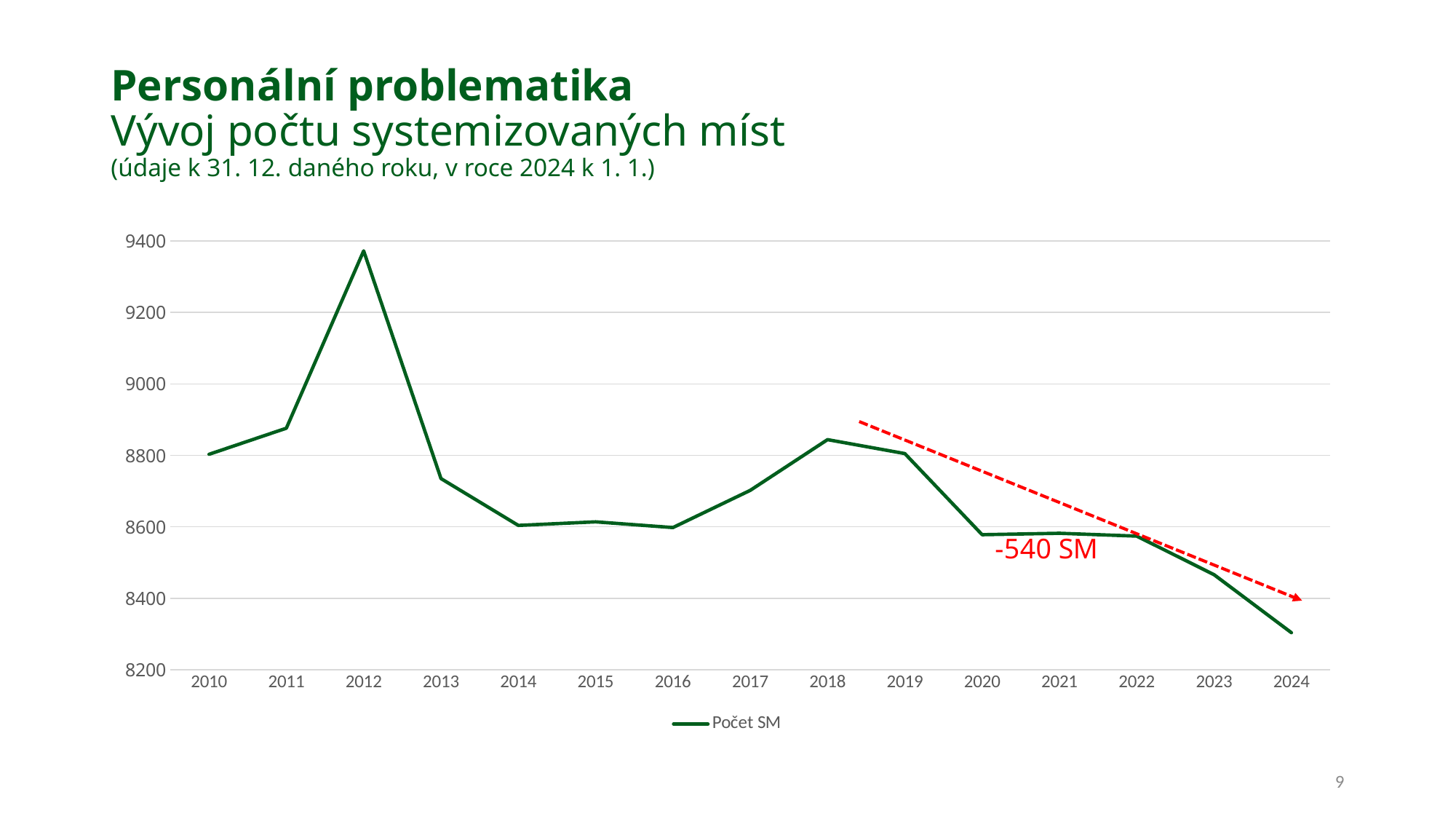
Which year has the larger value, 2011 or 2013? 2011 Which year has the highest value for Počet SM? 2012 Do the values rise or fall from 2018 to 2024? fall What kind of chart is shown on the slide? line chart Is the value for 2013 greater or less than 8800? less Is the value for 2012 greater or less than 9200? greater Which year has the larger value, 2018 or 2020? 2018 How many years are plotted on the x axis? 15 Is the value for 2024 greater or less than 8400? less Which year has the lowest value for Počet SM? 2024 How many series does the legend list? 1